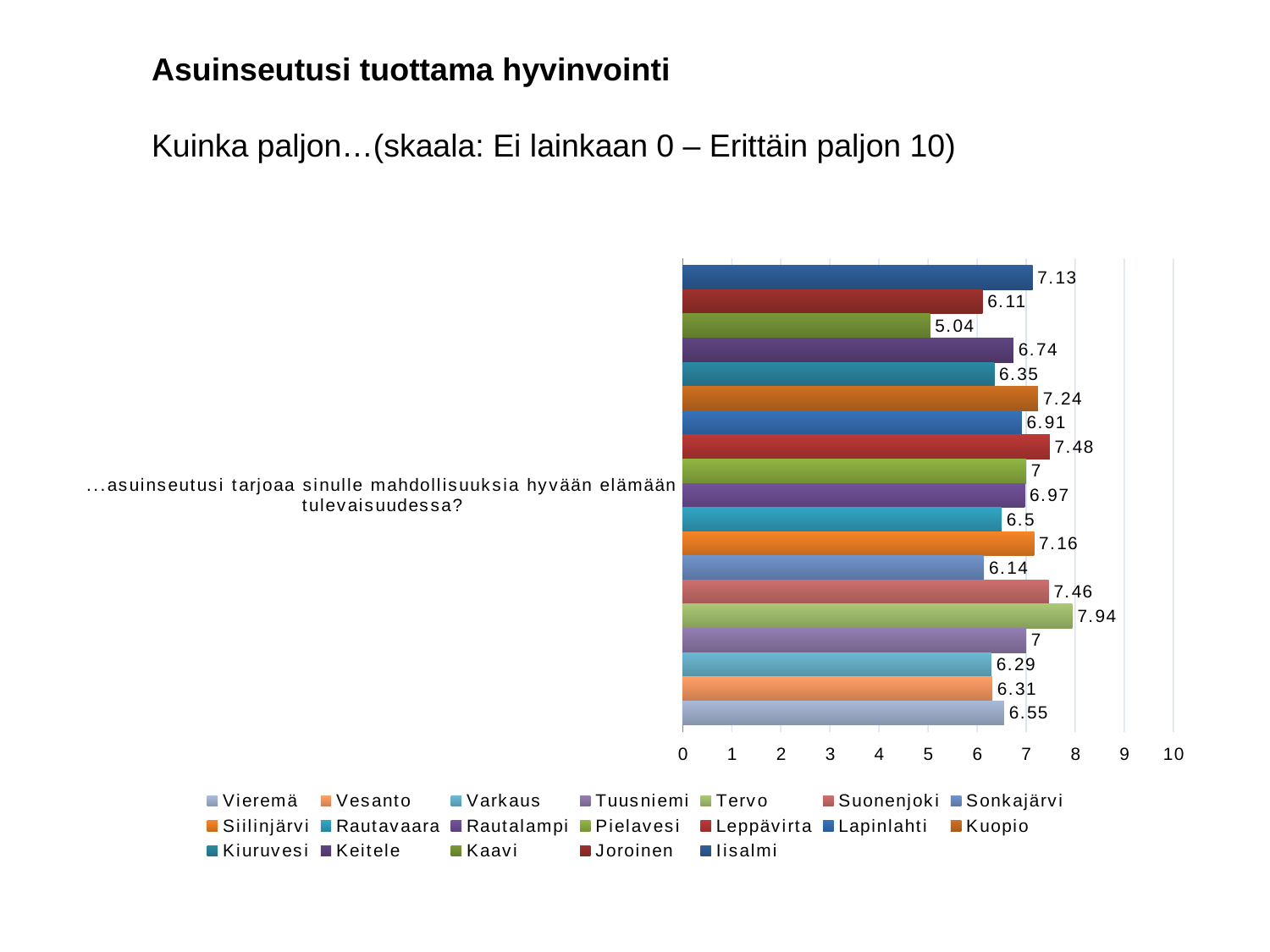
What is the value for Kaavi? 5.04 What is the value for Tervo? 7.94 What is the difference between the values for Tervo and Kaavi? 2.9 Which is larger, the value for Leppävirta or the value for Joroinen? Leppävirta What is the maximum value shown on the horizontal axis? 10 What is the value for Iisalmi? 7.13 Which municipality has the highest value? Tervo What type of chart is shown on the slide? bar chart How many series does the legend list? 19 Is the value for Kaavi greater or less than 6? less What is the value for Kuopio? 7.24 Which municipality has the lowest value? Kaavi